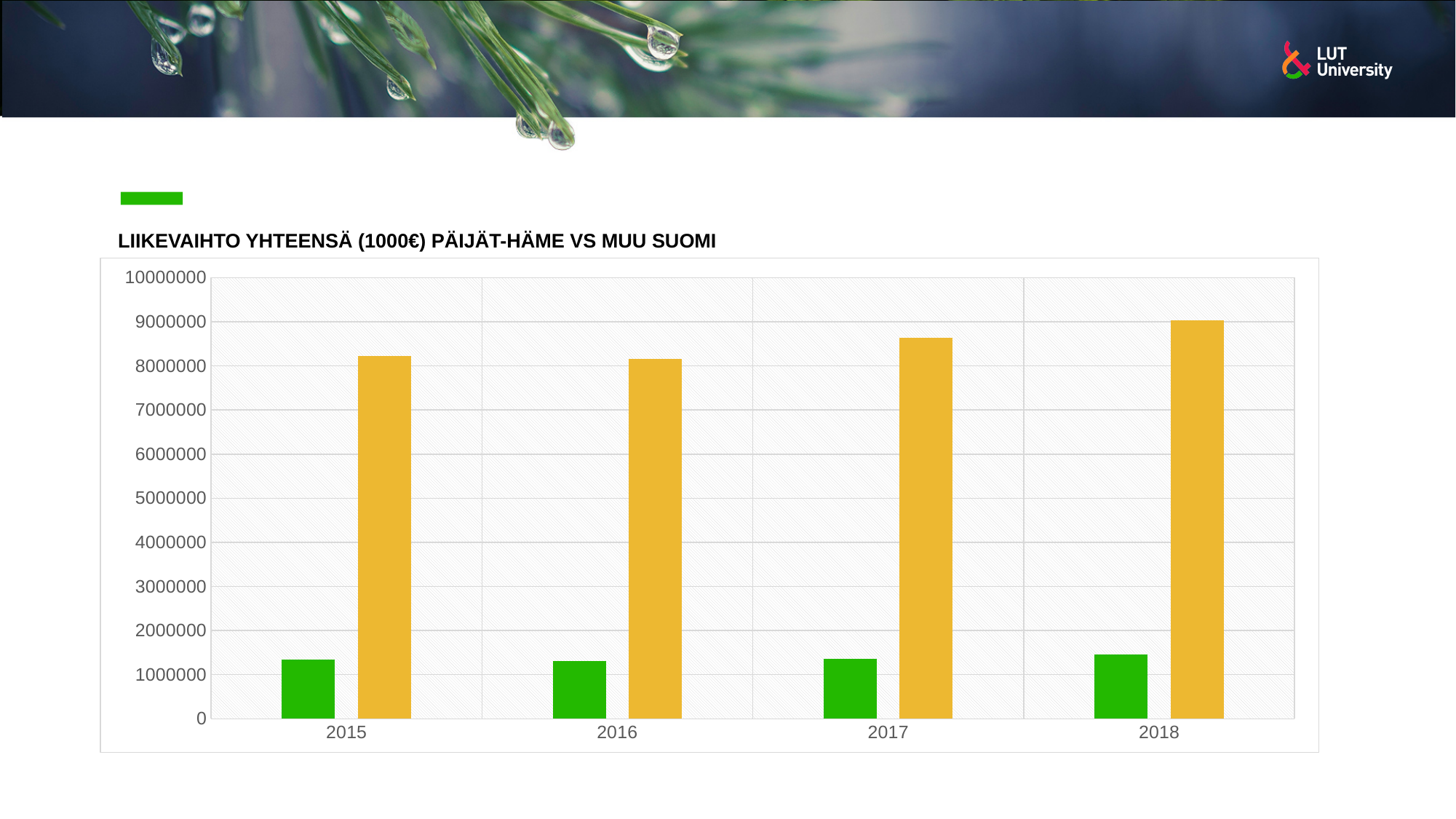
Do the yellow bars rise or fall from 2016 to 2018? rise In which year is the yellow bar the highest? 2018 Is the value of the green bar for 2018 greater or less than 1000000? greater How many years are shown on the x axis of the chart? 4 What is the title of the chart? LIIKEVAIHTO YHTEENSÄ (1000€) PÄIJÄT-HÄME VS MUU SUOMI How many bars are shown for each year in the chart? 2 Is the value of the yellow bar for 2017 greater or less than 9000000? less What kind of chart is shown on the slide? bar chart Is the value of the yellow bar for 2015 greater or less than 7000000? greater For 2017, which bar is larger, the green bar or the yellow bar? the yellow bar